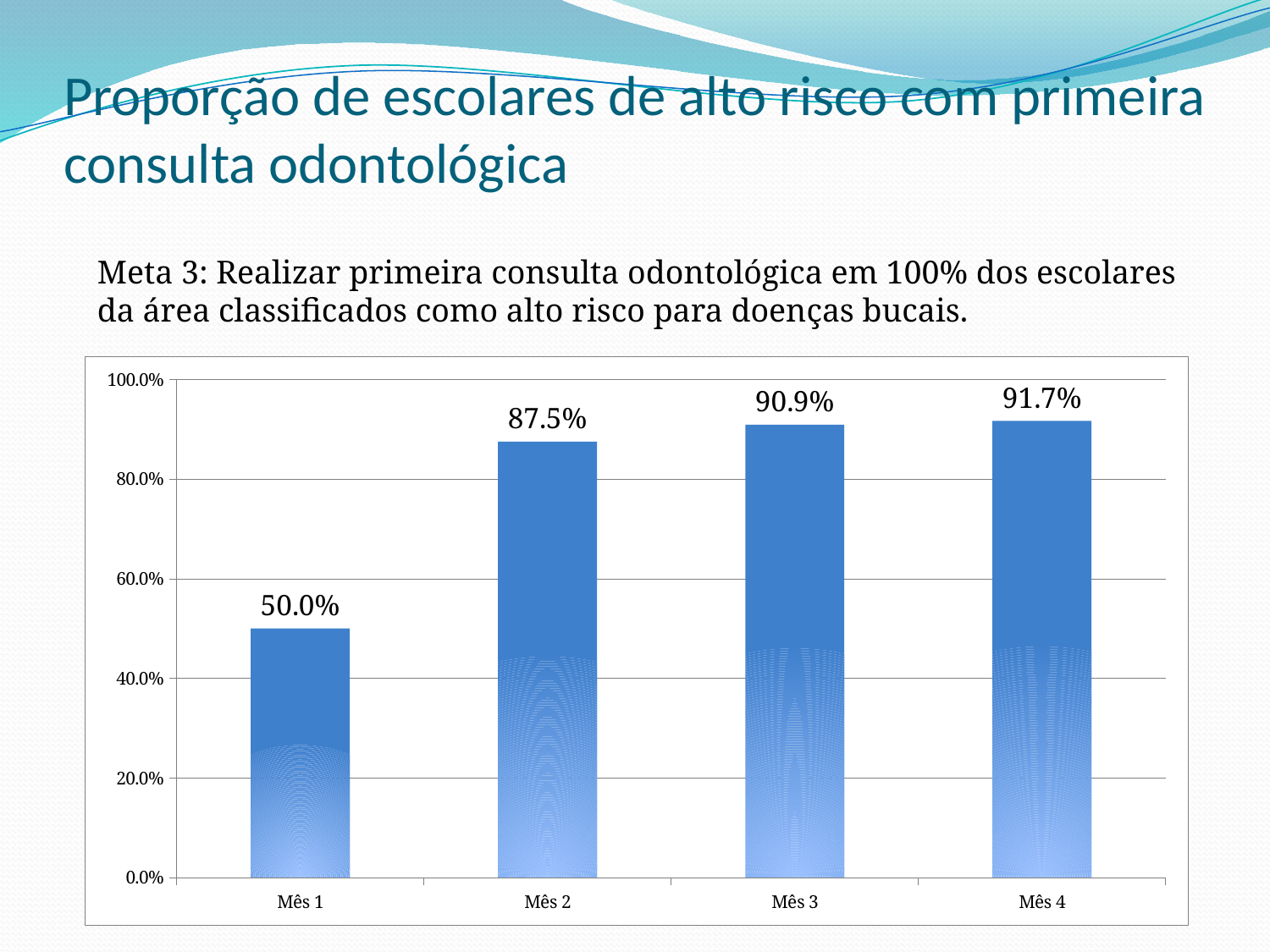
What kind of chart is shown on the slide? bar chart Which month has the lowest value? Mês 1 What is the difference between the values for Mês 4 and Mês 3? 0.8% What is the value for Mês 4? 91.7% What is the value for Mês 1? 50.0% Is the value for Mês 3 greater or less than 80.0%? greater Which month has the highest value? Mês 4 Which is larger, the value for Mês 1 or the value for Mês 2? Mês 2 What is the difference between the values for Mês 2 and Mês 1? 37.5% How many months are shown on the x axis? 4 What is the value for Mês 3? 90.9% What is the value for Mês 2? 87.5%